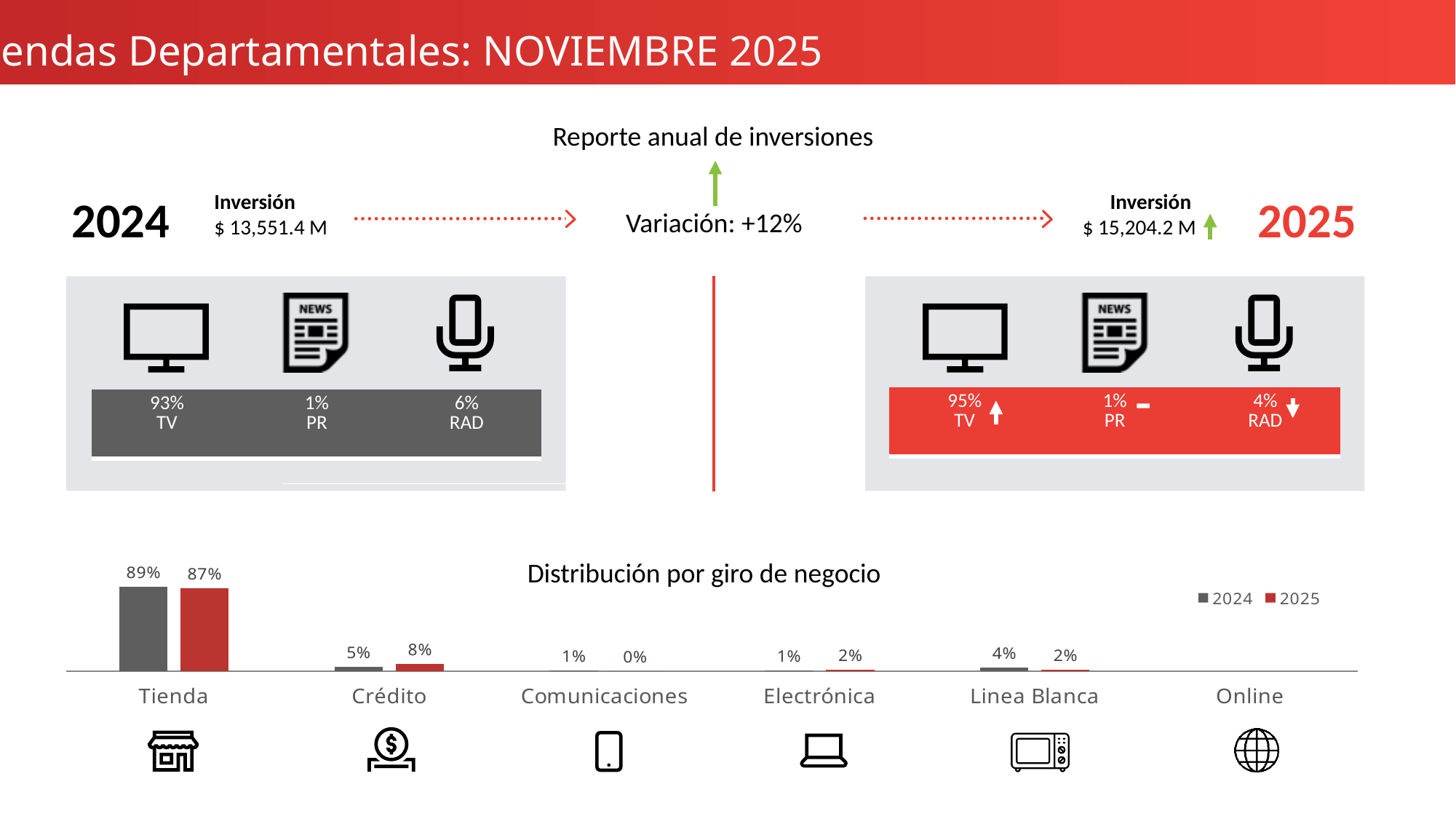
In the 'Distribución por giro de negocio' chart, is the 2024 or the 2025 value larger for Linea Blanca? 2024 In the 'Distribución por giro de negocio' chart, which category has the highest 2025 value? Tienda In the 'Distribución por giro de negocio' chart, what is the difference between the 2025 and 2024 values for Crédito? 3% What kind of chart is 'Distribución por giro de negocio'? Bar chart In the 'Distribución por giro de negocio' chart, what is the 2025 value for Crédito? 8% In the 'Distribución por giro de negocio' chart, what is the 2025 value for Comunicaciones? 0% In the 'Distribución por giro de negocio' chart, is the 2024 or the 2025 value larger for Electrónica? 2025 In the 'Distribución por giro de negocio' chart, what is the difference between the 2024 and 2025 values for Tienda? 2% In the 'Distribución por giro de negocio' chart, what is the 2024 value for Linea Blanca? 4% In the 'Distribución por giro de negocio' chart, which category has the lowest 2025 value among those with labelled bars? Comunicaciones In the 'Distribución por giro de negocio' chart, what is the 2024 value for Tienda? 89% How many series does the legend of the 'Distribución por giro de negocio' chart list? 2